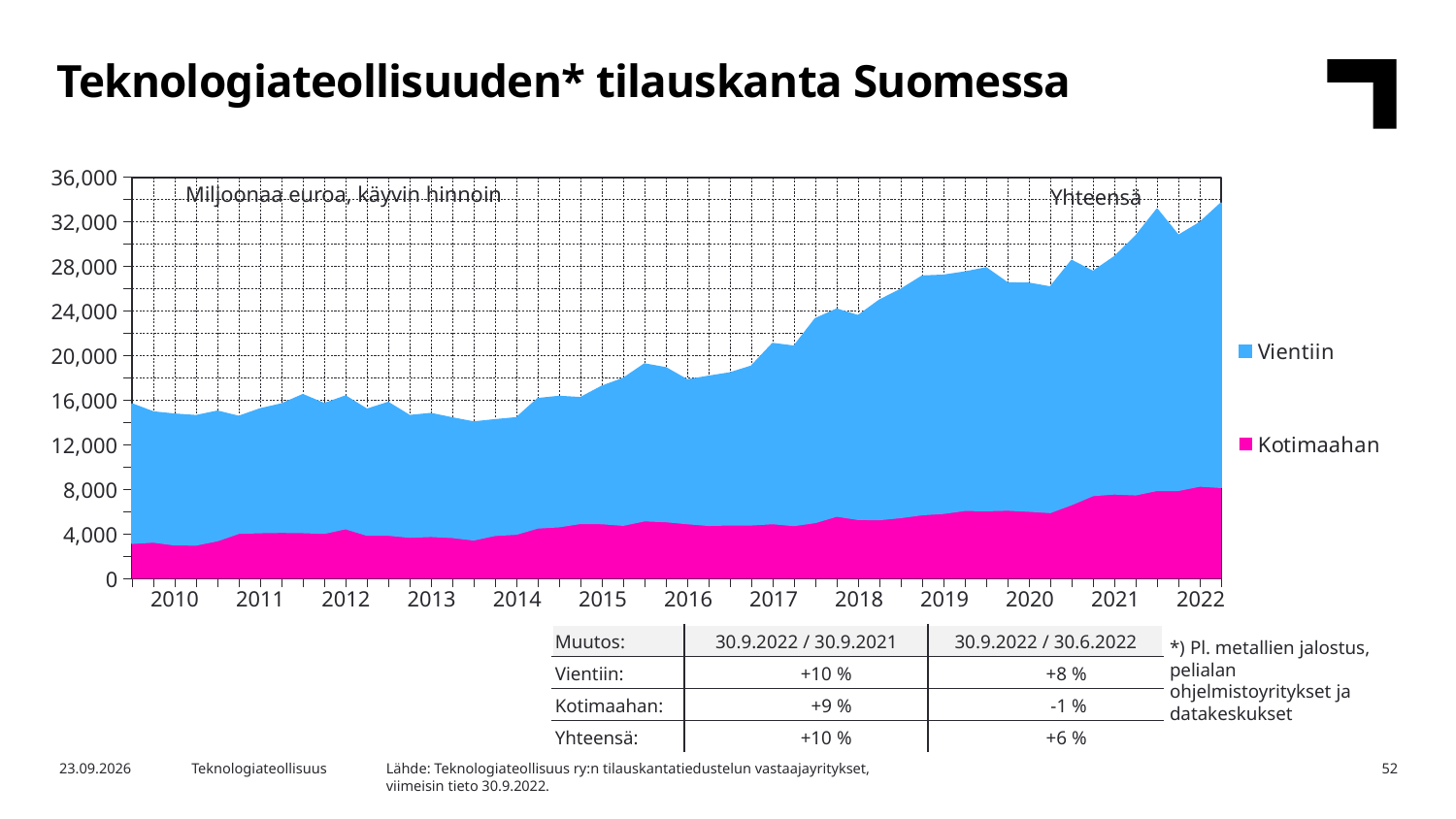
How many years are labelled on the x axis of the chart? 13 What are the two series named in the chart's legend? Vientiin and Kotimaahan How many series does the chart's legend list? 2 What unit is stated in the label at the top of the chart area? Miljoonaa euroa, käyvin hinnoin Is the total (Yhteensä) value at the end of 2022 greater or less than 28,000? greater Is the total (Yhteensä) value in 2019 greater or less than 24,000? greater Does the total order book (Yhteensä) generally rise or fall from 2010 to 2022? rise Is the Kotimaahan value in 2022 greater or less than 4,000? greater What kind of chart is shown on the slide? Stacked area chart Which series is larger throughout the chart, Vientiin or Kotimaahan? Vientiin